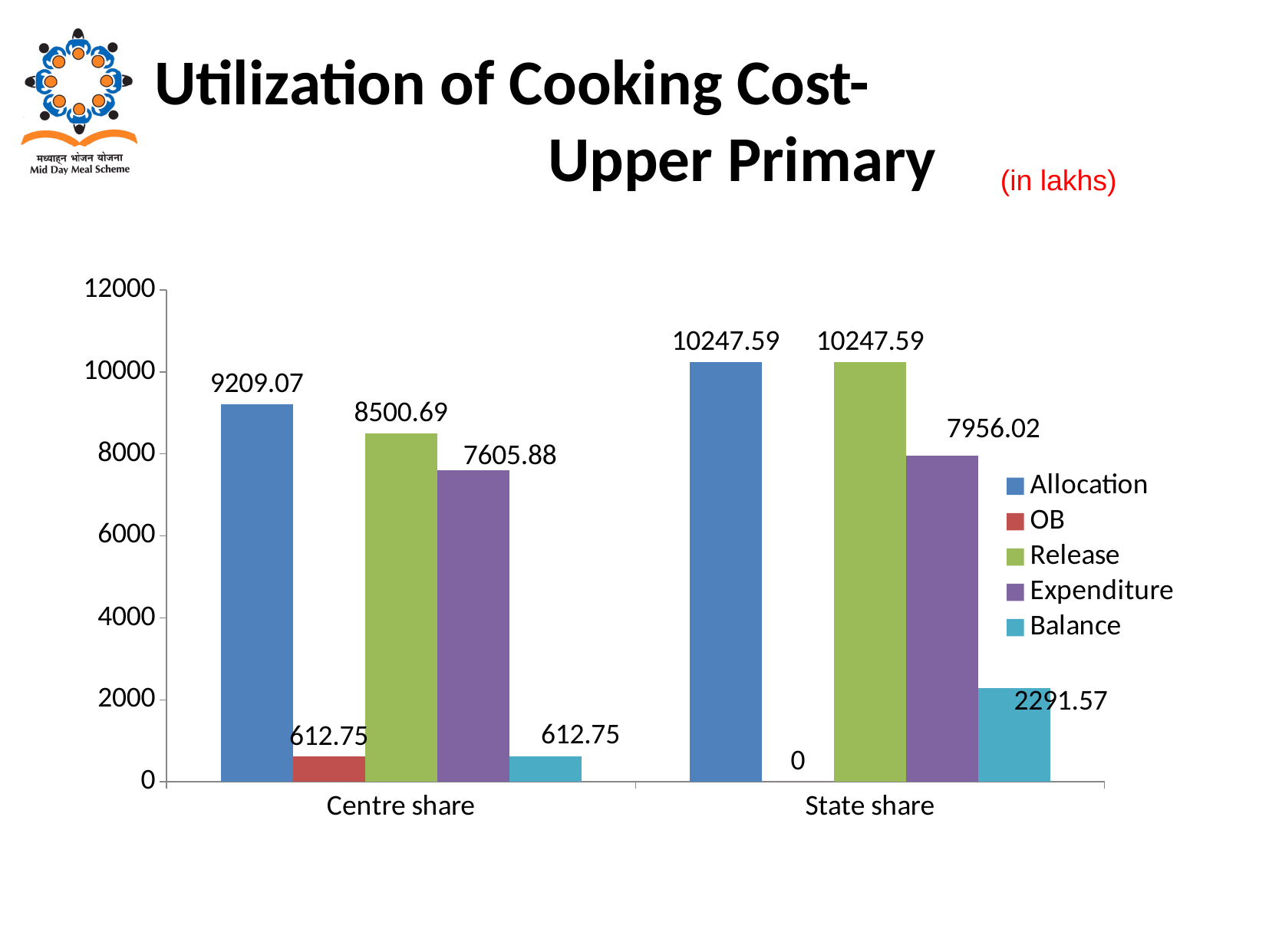
Which series has the highest value for State share? Allocation and Release (both 10247.59) What is the Balance value for State share? 2291.57 Which series has the lowest value for Centre share? OB and Balance (both 612.75) What kind of chart is shown on the slide? Bar chart What is the difference between Release and Expenditure for Centre share? 894.81 Which is larger, the Expenditure for Centre share or the Expenditure for State share? State share What is the OB value for State share? 0 What is the Expenditure value for State share? 7956.02 How many categories are shown on the x axis? 2 What is the Release value for Centre share? 8500.69 How many series does the legend list? 5 What is the Allocation value for Centre share? 9209.07